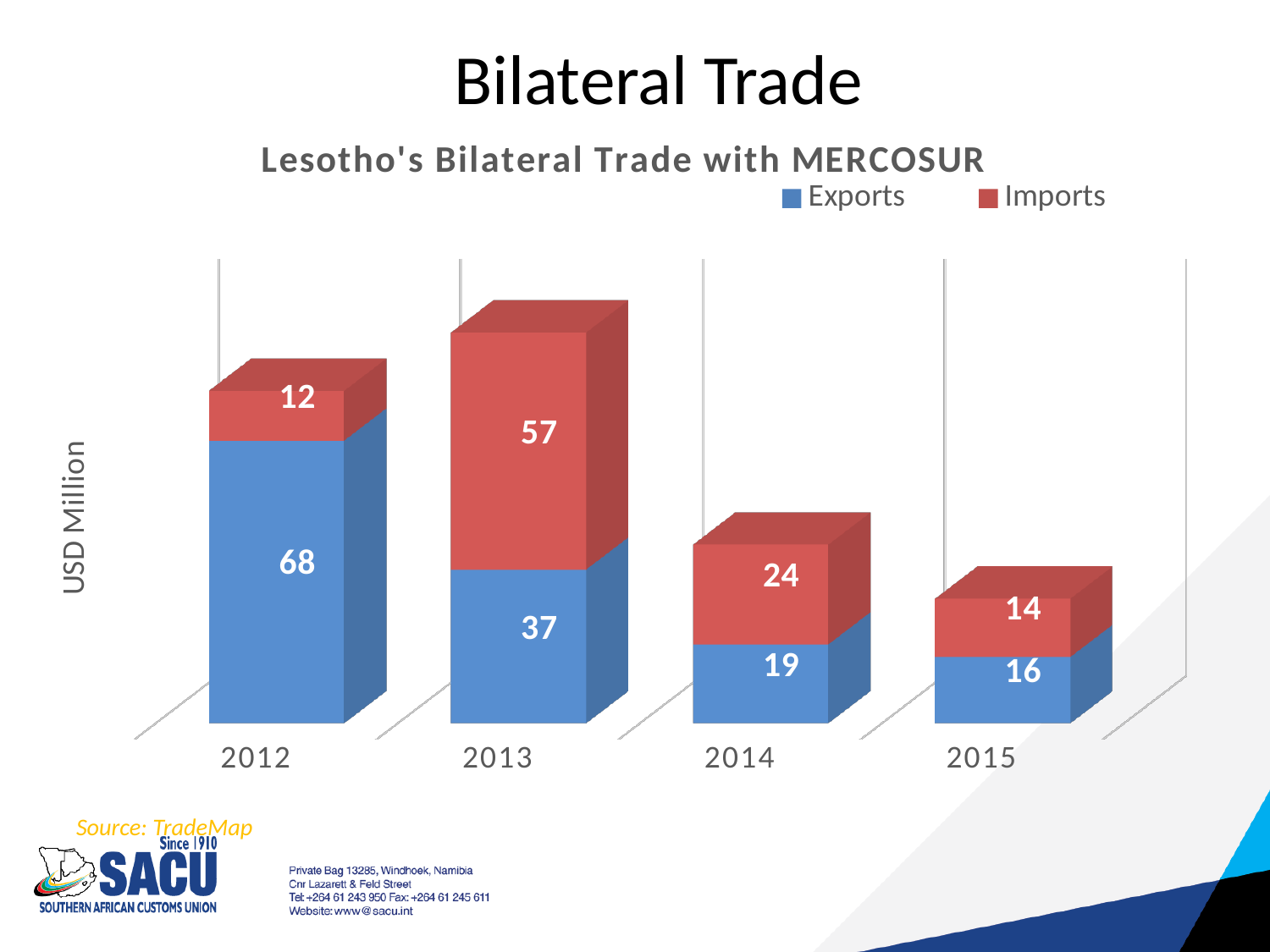
Which year has the lowest Imports value? 2012 What is the total of the stacked bar for 2012? 80 How many years are shown on the x axis? 4 What is the value of Exports in 2015? 16 What is the total of the stacked bar for 2015? 30 How many series does the legend list? 2 What is the value of Exports in 2012? 68 Which is larger in 2014, Exports or Imports? Imports Which year has the highest Exports value? 2012 What is the value of Imports in 2013? 57 What is the difference between Imports and Exports in 2013? 20 What kind of chart is shown? Stacked bar chart